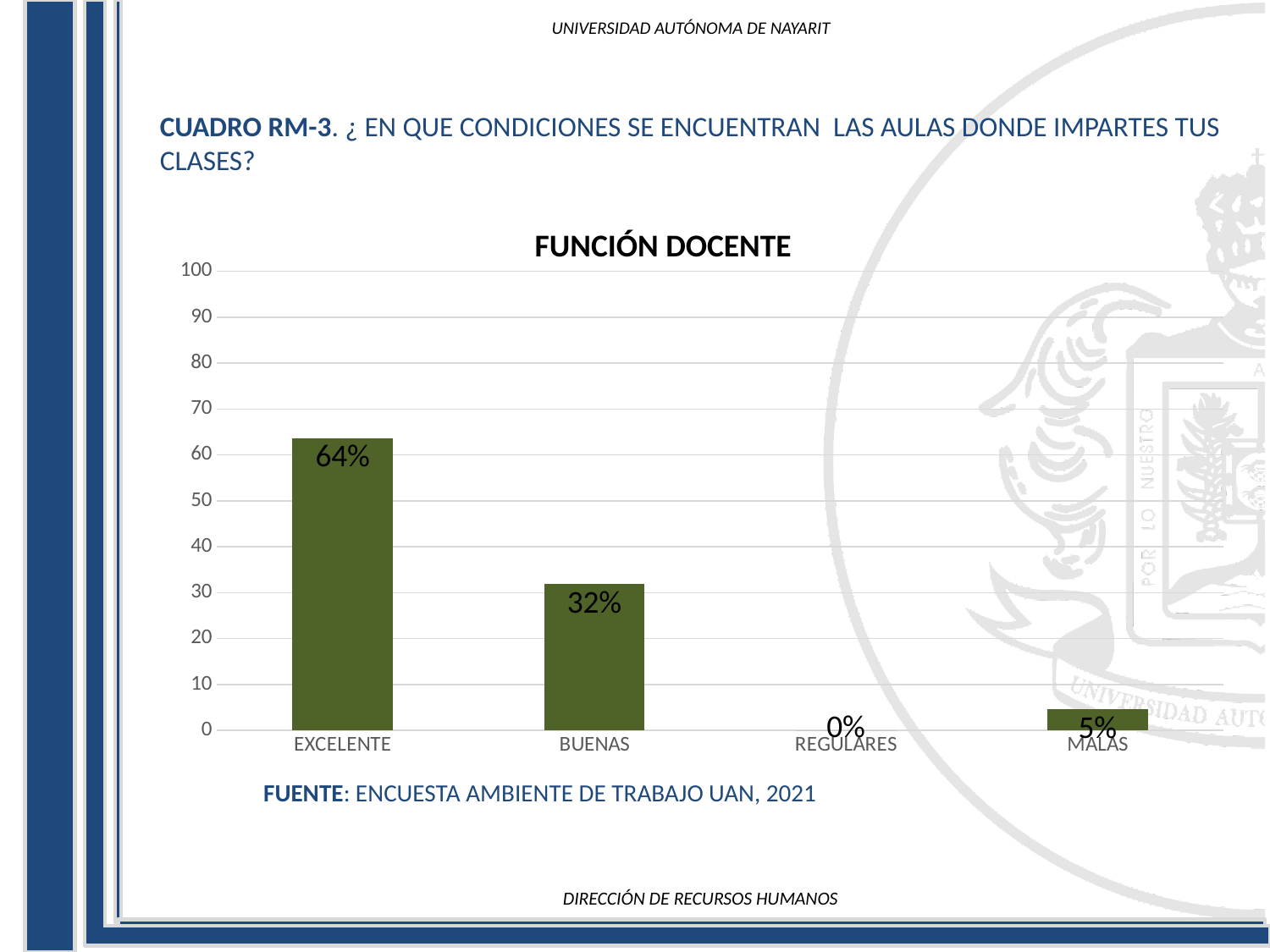
Which category has the lowest value? REGULARES What is the difference between the values for EXCELENTE and BUENAS? 32% What kind of chart is shown on the slide? bar chart What is the value for REGULARES? 0% What is the value for EXCELENTE? 64% Is the value for EXCELENTE greater or less than 50? greater What is the value for BUENAS? 32% How many categories are shown on the x axis? 4 Which is larger, the value for BUENAS or the value for MALAS? BUENAS What is the value for MALAS? 5% What is the title of the chart? FUNCIÓN DOCENTE Which category has the highest value? EXCELENTE